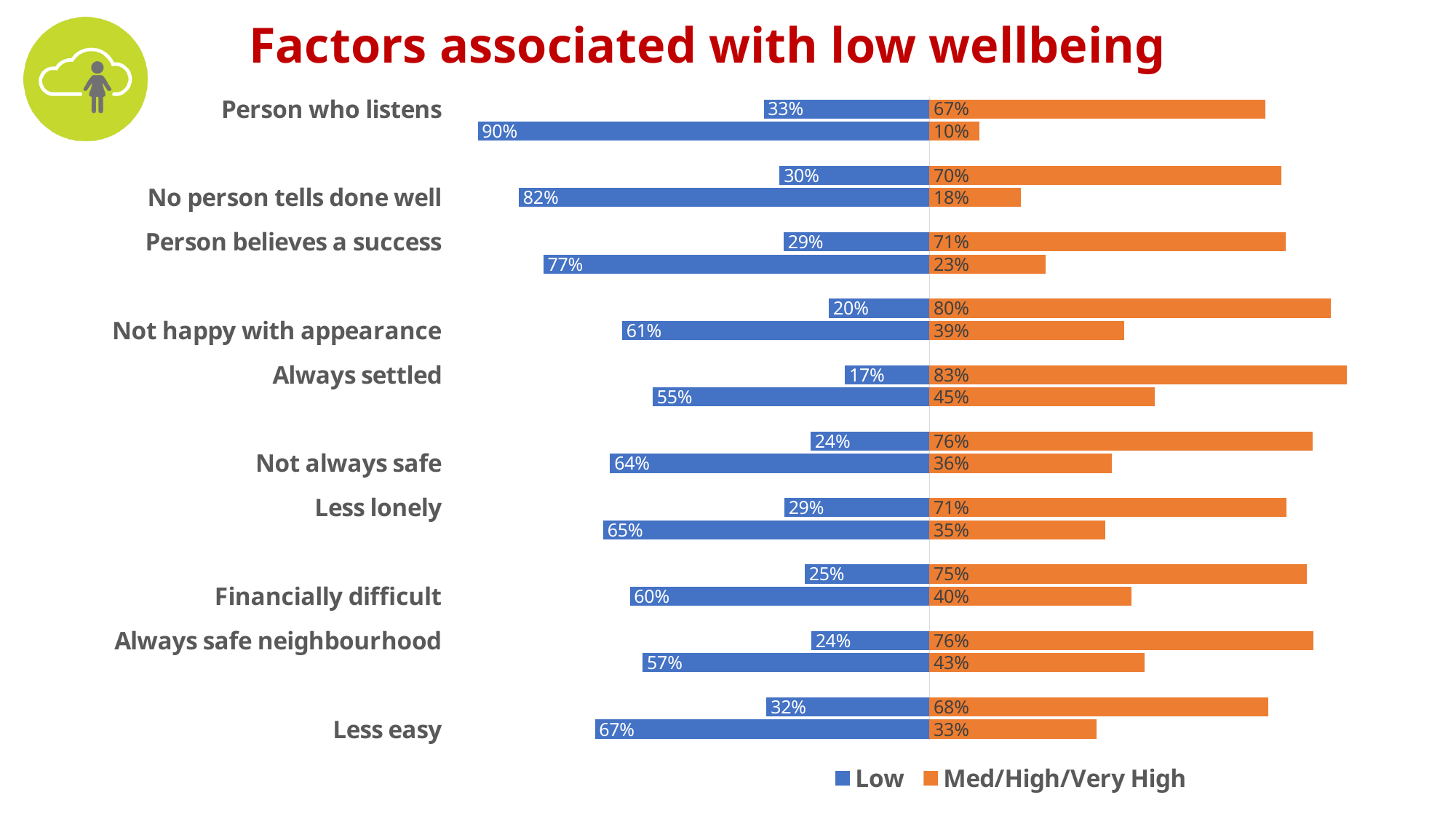
How many series does the legend list? 2 What is the smallest Low value printed on the chart? 17% What is the Low value in the lower row of bars for Financially difficult? 60% Which is larger: the Low value in the lower row for Person who listens (90%) or the Low value in the lower row for Less easy (67%)? Person who listens What is the Med/High/Very High value in the upper row of bars for Always settled? 83% What is the largest Low value printed anywhere on the chart? 90% What is the title of the chart? Factors associated with low wellbeing What kind of chart is shown on the slide? Bar chart What are the two series named in the legend? Low and Med/High/Very High How many factors are labelled on the vertical axis of the chart? 10 In the upper row of bars for Person who listens, what is the difference between the Med/High/Very High value (67%) and the Low value (33%)? 34 percentage points Which factor has the bar with the largest Low value (90%)? Person who listens